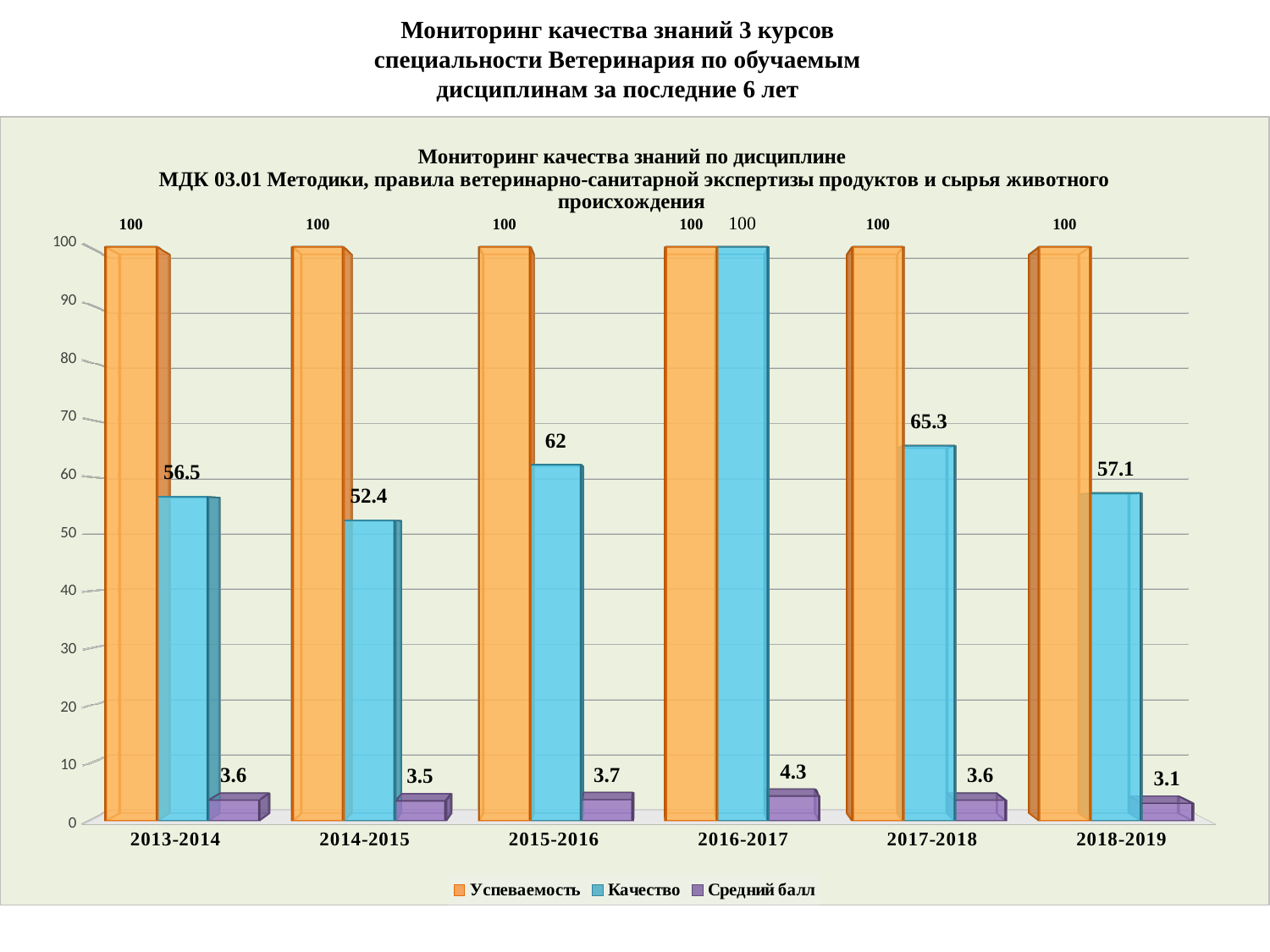
What is the value of Качество for 2017-2018? 65.3 What kind of chart is shown on the slide? Bar chart Which is larger: Качество in 2013-2014 or Качество in 2018-2019? 2018-2019 How many academic years are shown on the x axis? 6 In which academic year is Качество the highest? 2016-2017 What is the difference between Качество in 2017-2018 and in 2014-2015? 12.9 What is the value of Успеваемость for 2018-2019? 100 Which colour represents the Средний балл series in the legend? Purple In which academic year is Средний балл the lowest? 2018-2019 What is the value of Качество for 2015-2016? 62 How many series does the legend list? 3 What is the value of Средний балл for 2016-2017? 4.3